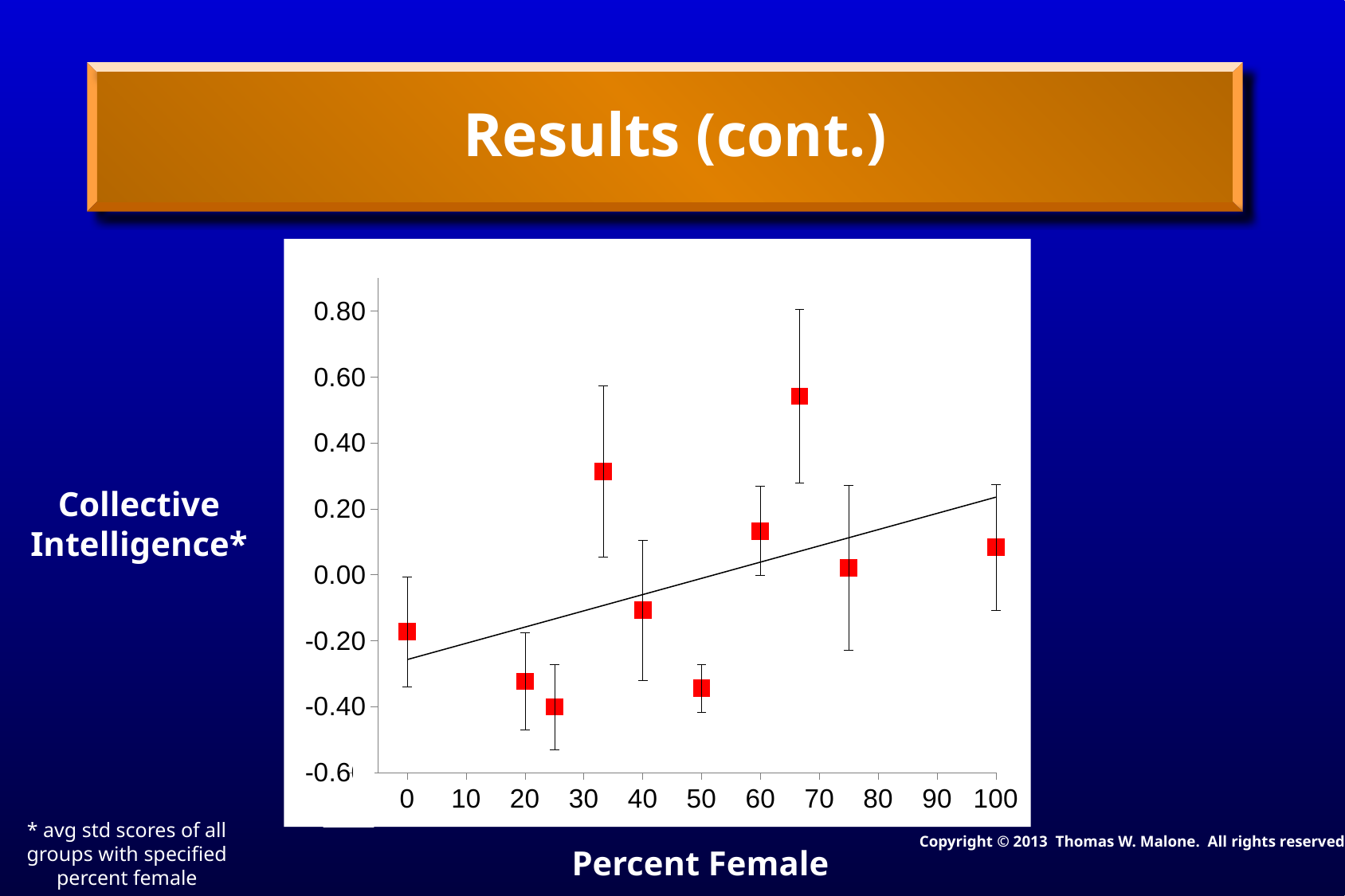
How many data points are plotted on the chart? 10 Is the collective intelligence value at 0 percent female greater or less than 0.00? less Which point has the higher collective intelligence: the one at 50 percent female or the one at 60 percent female? 60 percent female What kind of chart is shown on the slide? Scatter plot Which point has the higher collective intelligence: the one at 0 percent female or the one at 20 percent female? 0 percent female What is the title of the x axis? Percent Female What quantity is plotted on the y axis? Collective Intelligence* Is the collective intelligence value at 100 percent female greater or less than 0.00? greater Is the collective intelligence value at 50 percent female greater or less than -0.20? less Which point has the highest collective intelligence: the one between 30 and 40 percent female or the one between 60 and 70 percent female? The one between 60 and 70 percent female According to the fitted line, does collective intelligence rise or fall as percent female increases? Rises